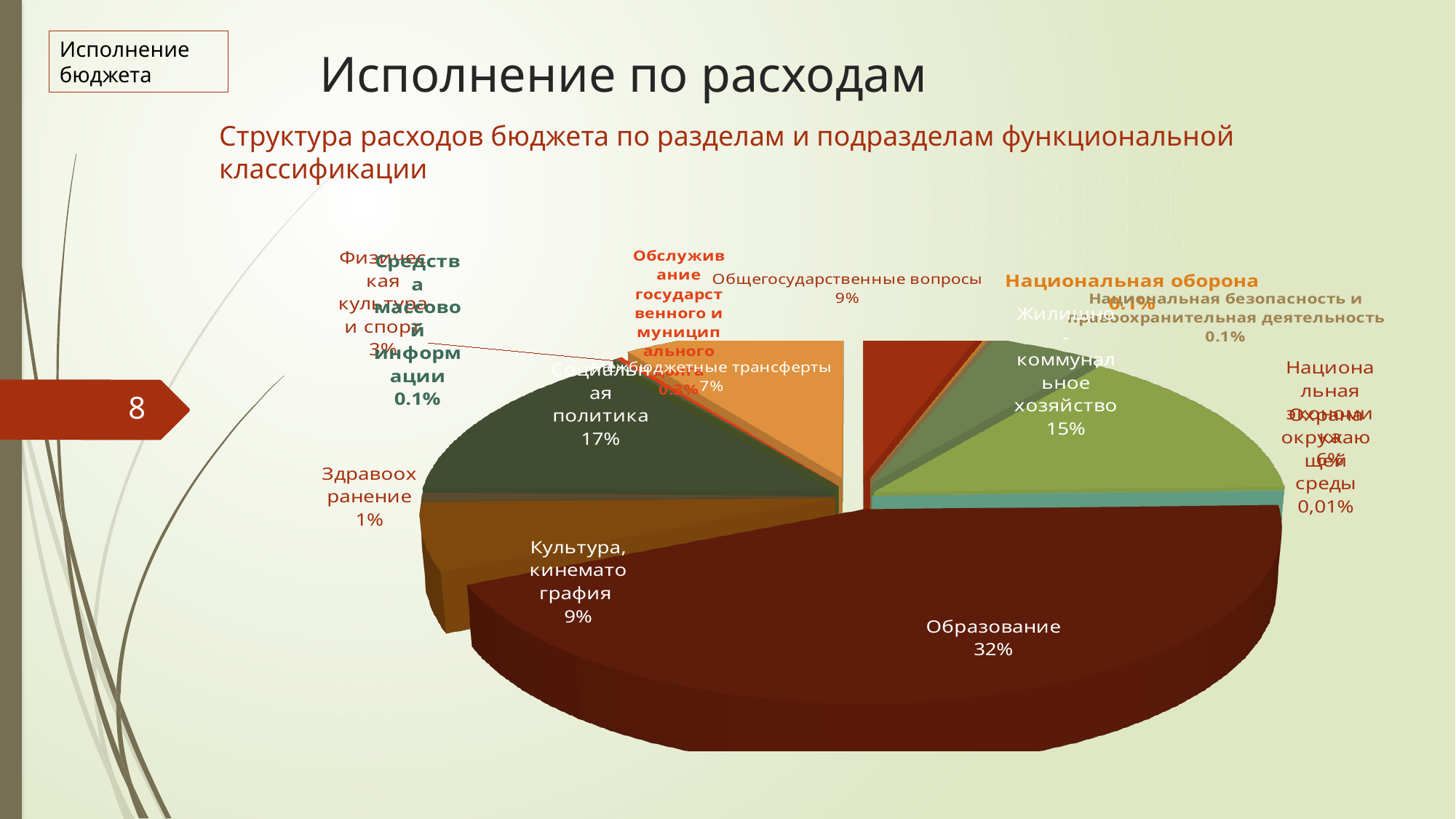
What is the value shown for Здравоохранение? 1% Which category has the smallest share of the pie? Охрана окружающей среды Which is larger: Жилищно-коммунальное хозяйство or Социальная политика? Социальная политика What kind of chart is shown on the slide? pie chart What share of expenditures does Образование account for? 32% What is the value shown for Охрана окружающей среды? 0,01% What is the value shown for Жилищно-коммунальное хозяйство? 15% What is the difference between the shares of Образование and Социальная политика? 15 percentage points What is the value shown for Национальная экономика? 6% What is the value shown for Межбюджетные трансферты? 7% What is the value shown for Социальная политика? 17% Which category has the largest share of the pie? Образование